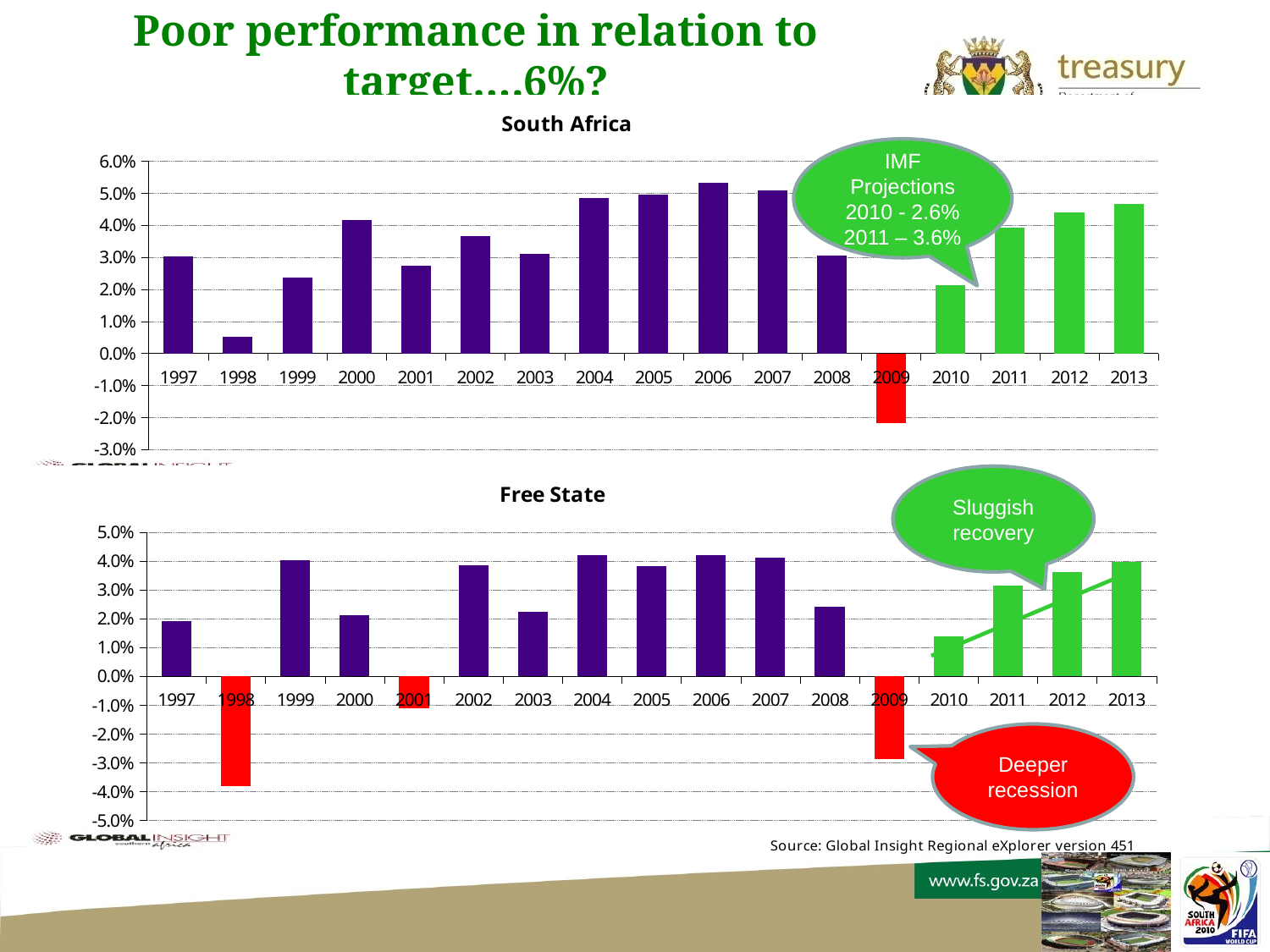
In the South Africa chart, do the values rise or fall from 2010 to 2013? rise In the South Africa chart, is the value for 1998 greater or less than 1.0%? less How many years are plotted on the Free State chart? 17 In the Free State chart, which year has the lowest value? 1998 In the South Africa chart, is the value for 2006 greater or less than 5.0%? greater What kind of chart is the South Africa chart? bar chart In the Free State chart, which year has the larger value, 1999 or 2000? 1999 In the Free State chart, is the value for 2010 greater or less than 2.0%? less According to the callout on the South Africa chart, what is the IMF projection for 2010? 2.6% In the South Africa chart, which year has the larger value, 2000 or 2001? 2000 In the South Africa chart, which year has the lowest value? 2009